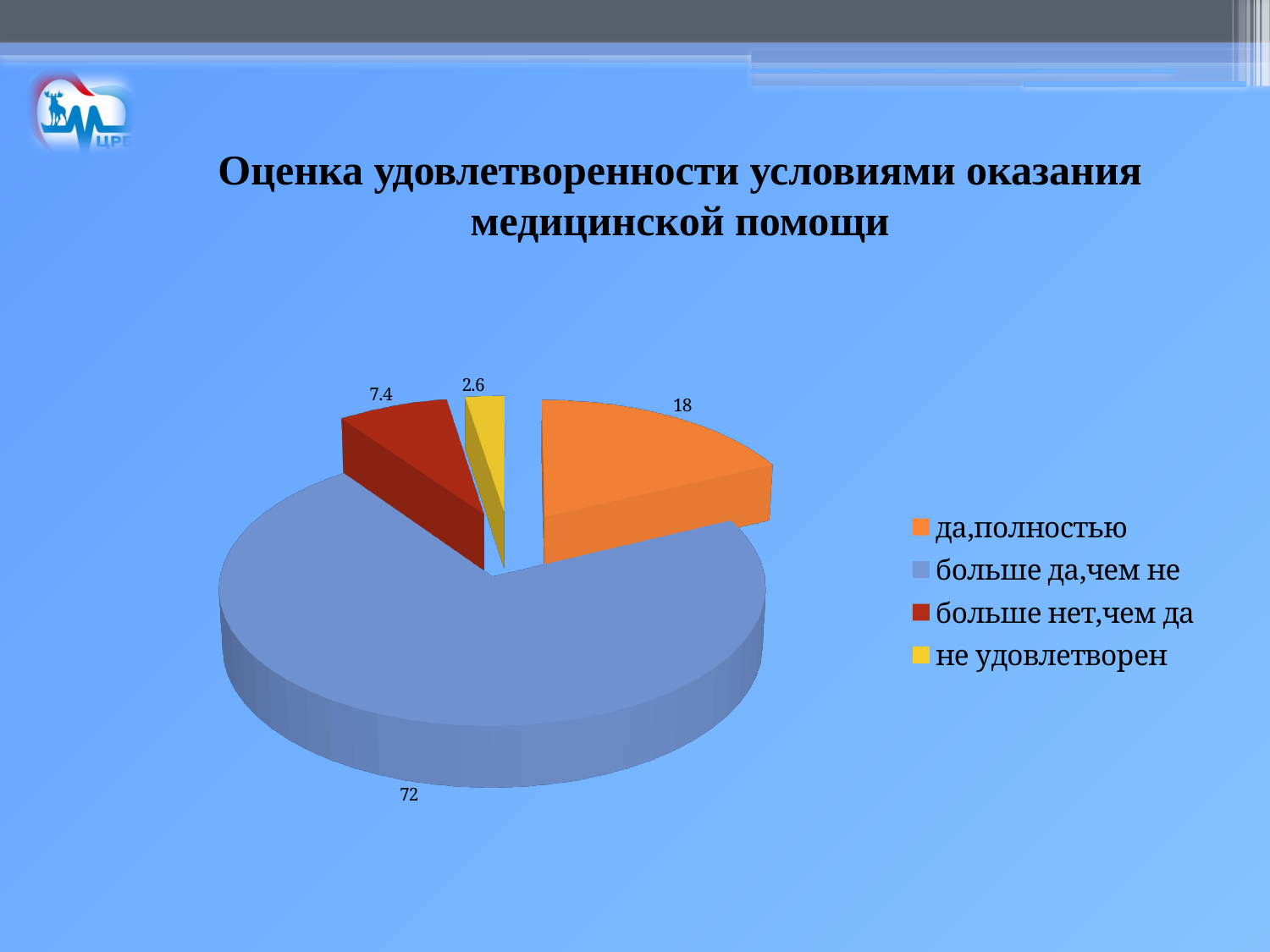
What is the value for "больше нет,чем да"? 7.4 Which category has the smallest slice? не удовлетворен What is the value for "больше да,чем не"? 72 What kind of chart is shown on the slide? pie chart Which category has the largest slice? больше да,чем не What is the difference between the values for "больше да,чем не" and "да,полностью"? 54 What is the value for "не удовлетворен"? 2.6 What colour is the slice for "больше нет,чем да"? red What is the title of the chart on the slide? Оценка удовлетворенности условиями оказания медицинской помощи Which is larger, the value for "больше нет,чем да" or the value for "не удовлетворен"? больше нет,чем да How many slices does the pie chart have? 4 What is the value for "да,полностью"? 18